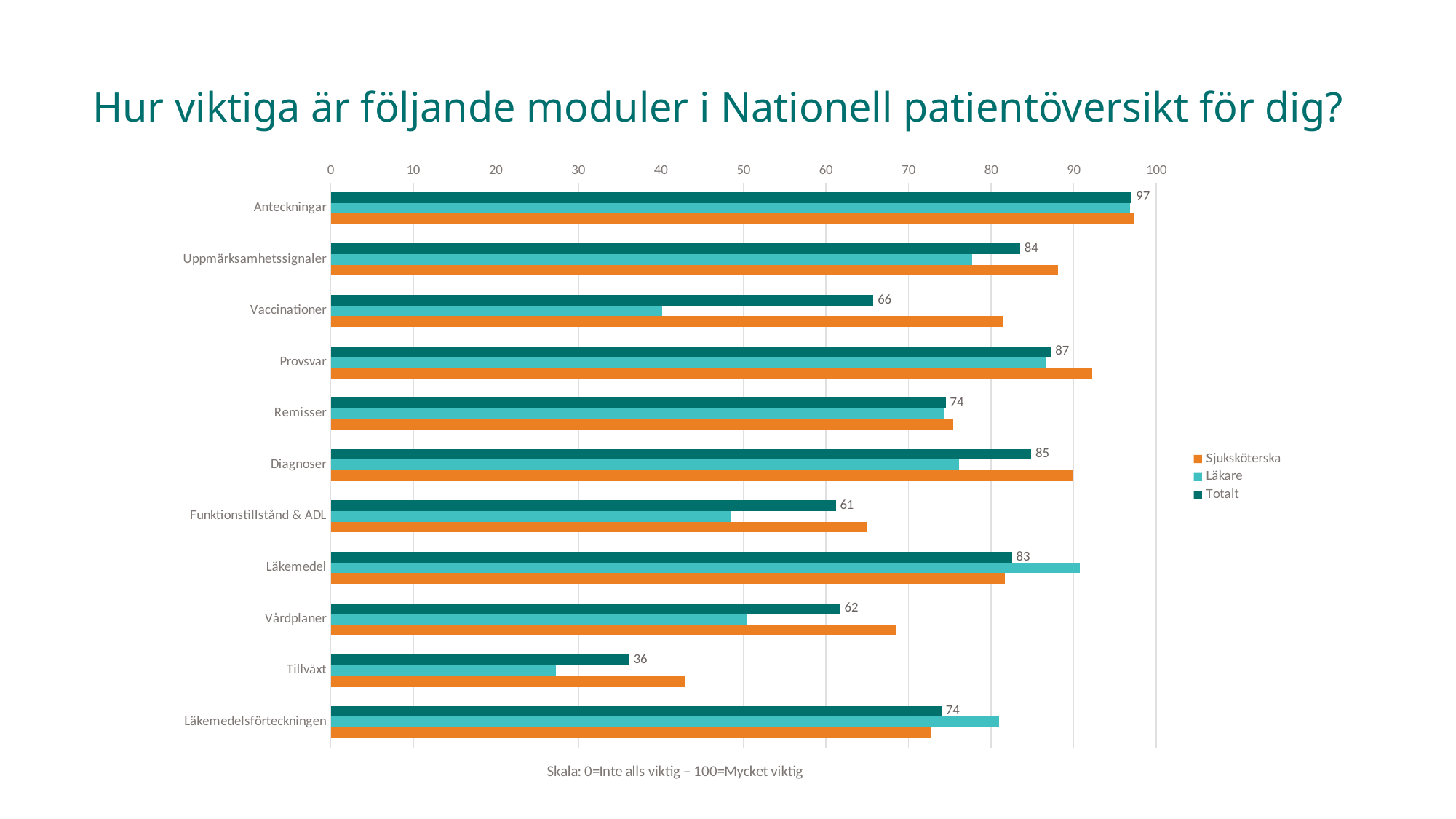
What is the Totalt value for Anteckningar? 97 What is the Totalt value for Tillväxt? 36 What kind of chart is shown on the slide? Bar chart What is the difference between the Totalt values for Anteckningar and Tillväxt? 61 Which has a larger Totalt value, Vaccinationer or Vårdplaner? Vaccinationer How many series does the legend list? 3 What is the Totalt value for Diagnoser? 85 How many modules are listed on the chart? 11 Is the Läkare value for Tillväxt greater or less than 30? less Is the Sjuksköterska value for Provsvar greater or less than 90? greater Which module has the highest Totalt value? Anteckningar Which module has the lowest Totalt value? Tillväxt